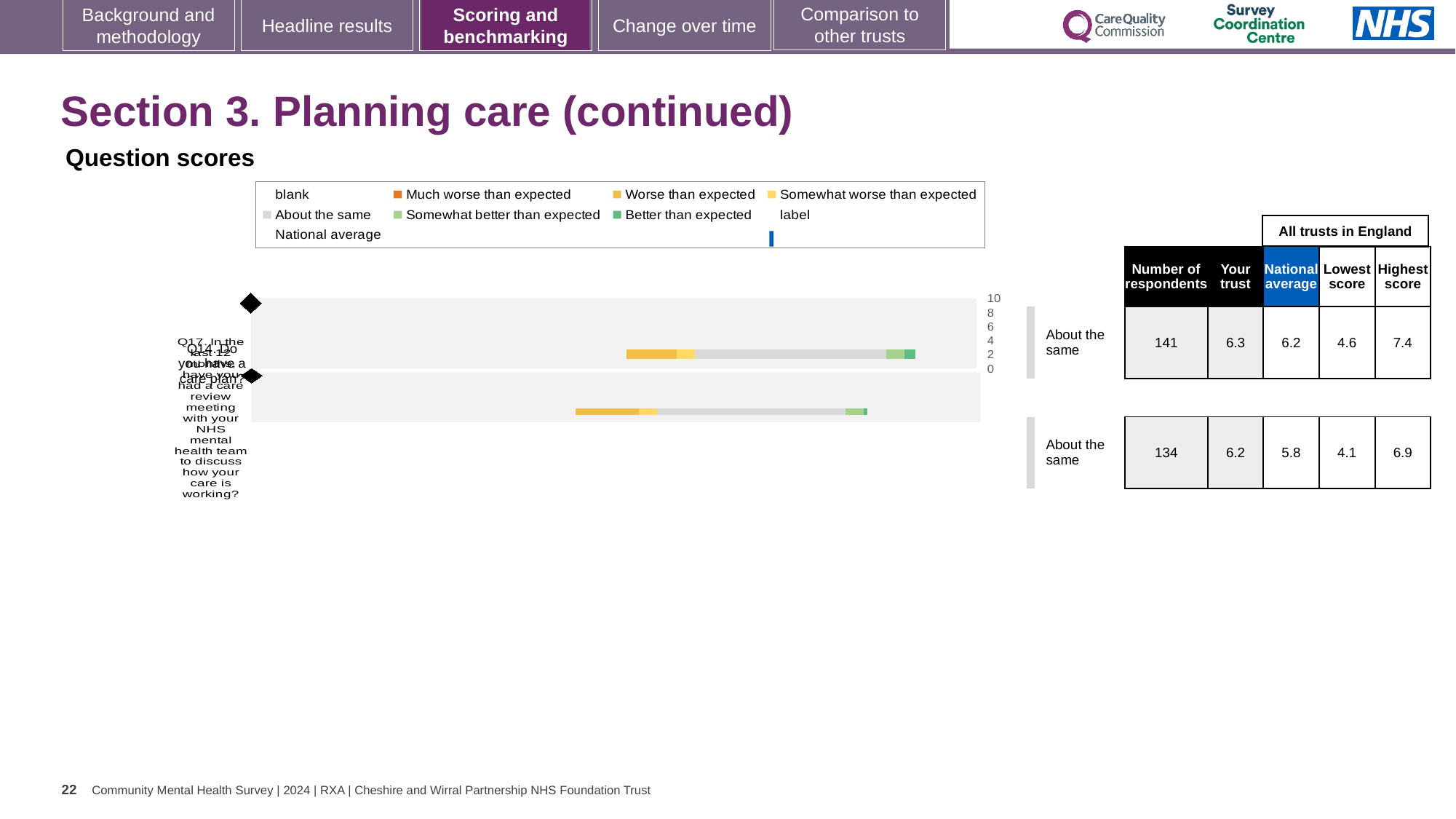
How many questions (bars) are plotted in the question scores chart? 2 Which question had more respondents, Q14 or Q17? Q14 For Q17 (the bottom row), is the 'Your trust' score higher or lower than the national average? higher What is the 'Your trust' score for Q14 (the top row)? 6.3 What is the national average score for Q17 (the bottom row)? 5.8 How many respondents answered Q14 (the top row)? 141 What is the lowest score among all trusts in England for Q14 (the top row)? 4.6 What kind of chart is used to show the question scores on this slide? bar chart By how much does the 'Your trust' score for Q14 exceed the national average for Q14? 0.1 What is the difference between the highest and lowest scores for Q17 (the bottom row)? 2.8 What benchmark category is shown next to both question bars? About the same What is the highest score among all trusts in England for Q17 (the bottom row)? 6.9